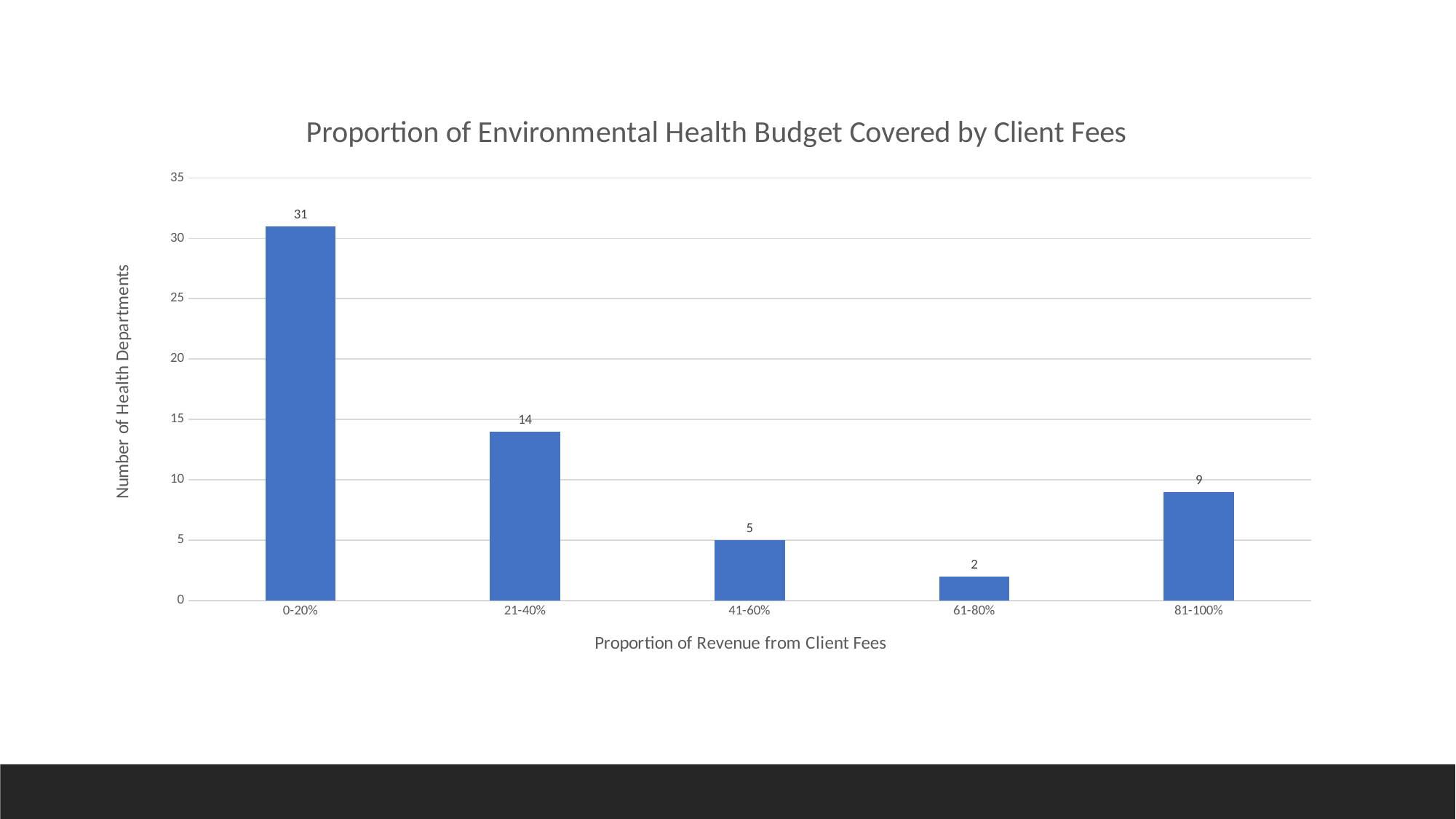
What kind of chart is shown on the slide? Bar chart What is the difference between the values for 0-20% and 21-40%? 17 How many categories are shown on the x axis? 5 What is the title of the chart? Proportion of Environmental Health Budget Covered by Client Fees How many health departments are in the 81-100% category? 9 Which category has the lowest number of health departments? 61-80% How many health departments fall in the 0-20% category? 31 What is the difference between the values for 81-100% and 41-60%? 4 Which is larger, the value for 41-60% or the value for 81-100%? 81-100% Is the value for 21-40% greater or less than 10? greater Which category has the highest number of health departments? 0-20% What is the value for the 21-40% category? 14